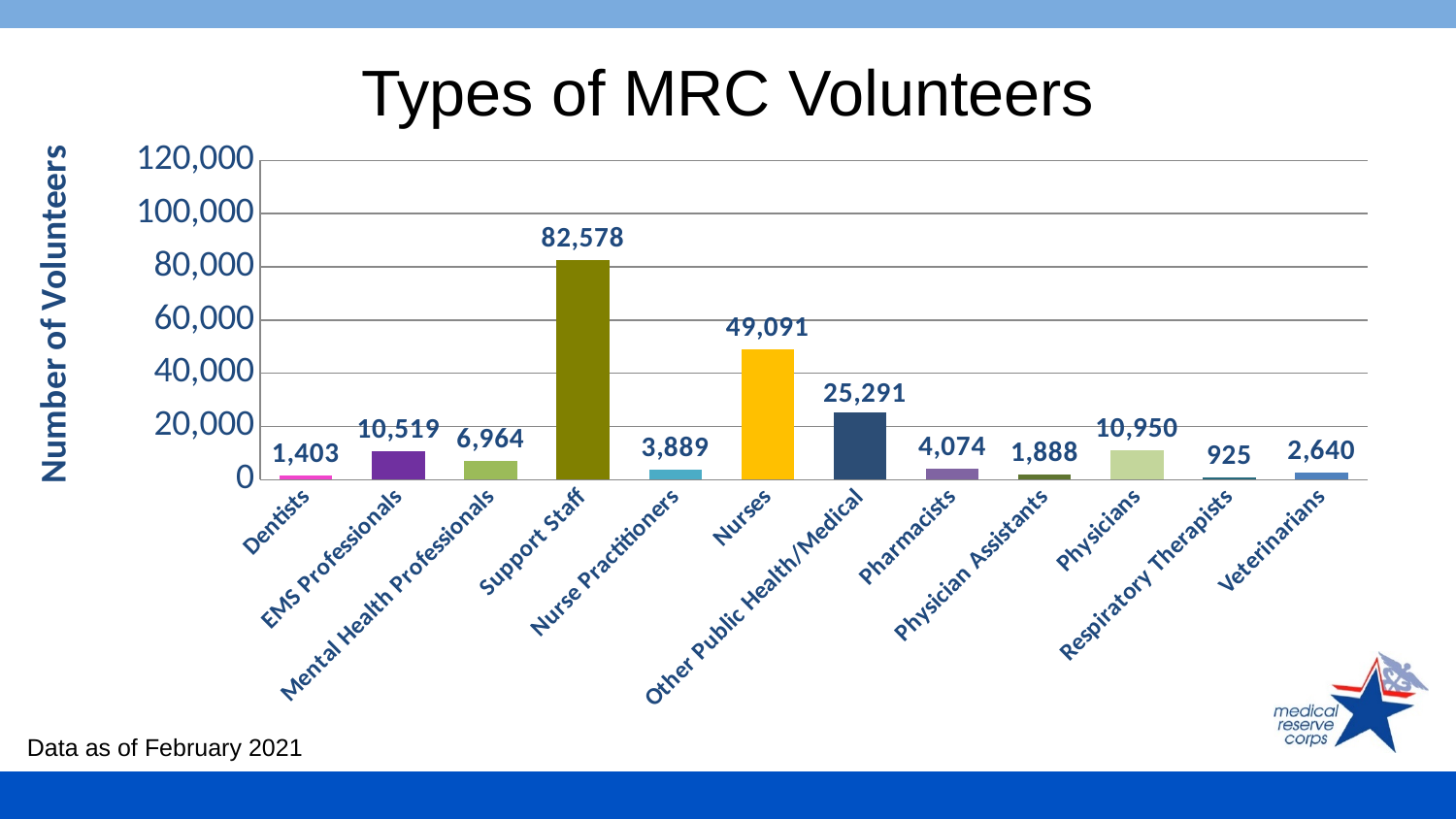
What is the difference between the number of Support Staff and Nurses? 33,487 How many volunteer types are shown on the chart? 12 How many Veterinarians are shown? 2,640 Is the value for Other Public Health/Medical greater or less than 20,000? greater What is the number of Nurse volunteers? 49,091 What is the title of the chart? Types of MRC Volunteers How many volunteers are Support Staff? 82,578 Which type of volunteer has the lowest number? Respiratory Therapists What is the difference between Physicians and EMS Professionals? 431 Which type of volunteer has the highest number? Support Staff Which has more volunteers, Pharmacists or Mental Health Professionals? Mental Health Professionals What kind of chart is shown? Bar chart